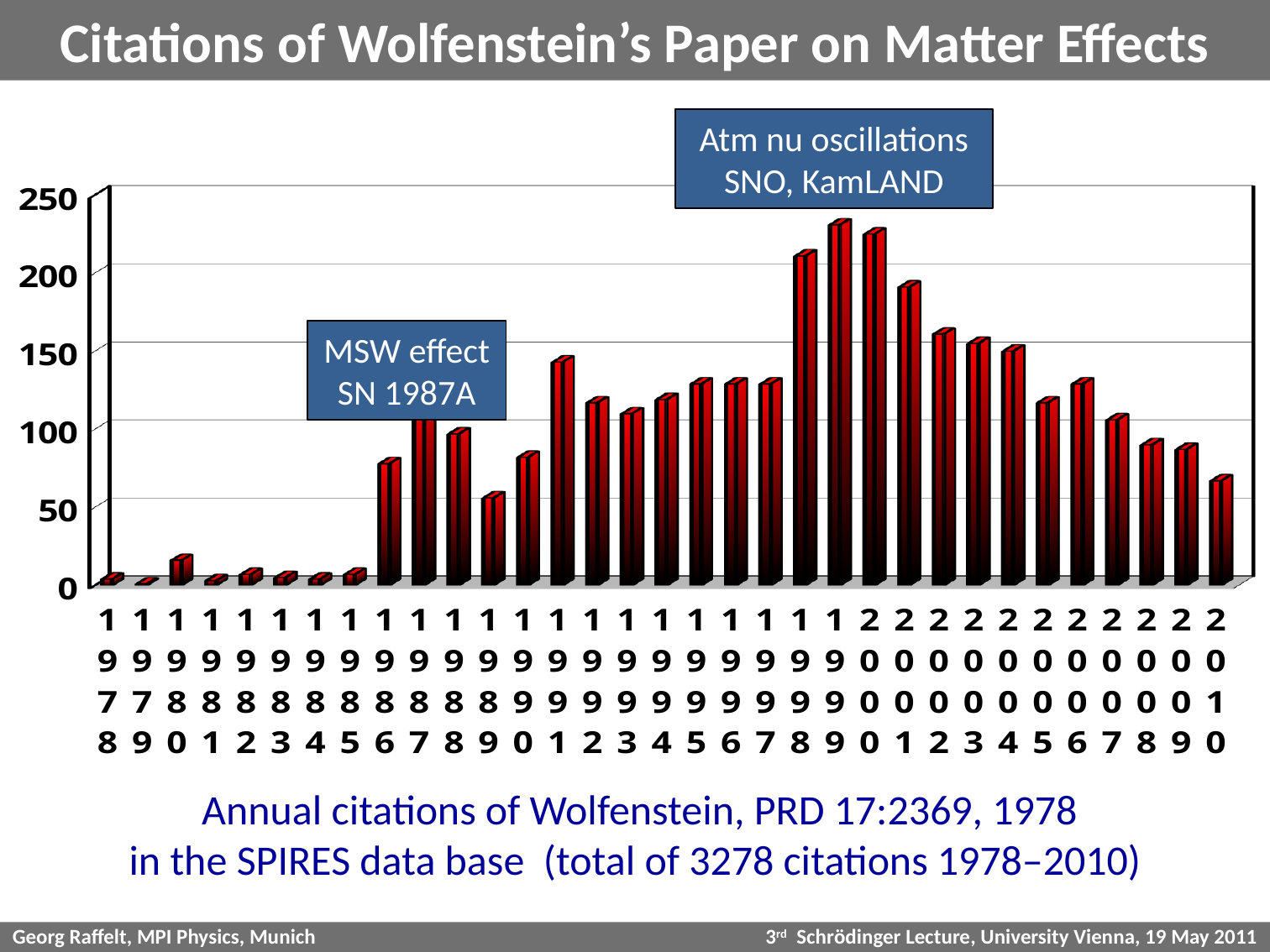
Is the value for 1986 greater or less than 100? less Which year has more citations, 1998 or 1991? 1998 What kind of chart is shown on the slide? bar chart Is the value for 2001 greater or less than 200? less Which year has the highest number of citations? 1999 Is the value for 2010 greater or less than 50? greater How many years (bars) are plotted in the chart? 33 Do the citation counts rise or fall from 1999 to 2010? fall What is the title of the slide's chart? Citations of Wolfenstein's Paper on Matter Effects